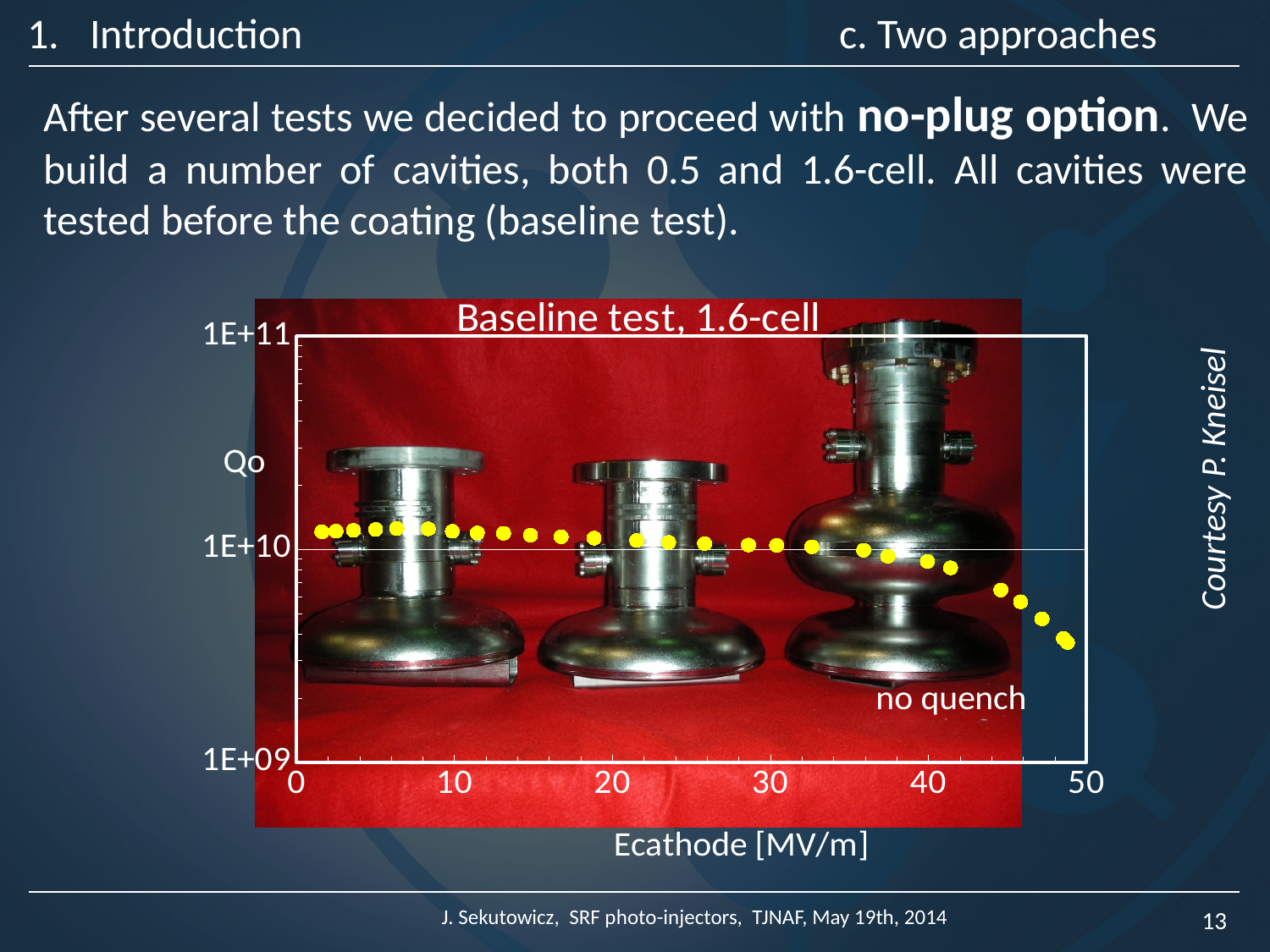
What kind of chart is shown on the slide? scatter chart Is the Qo value at an Ecathode of about 5 MV/m greater or less than 1E+10? greater Is the Qo value at the highest Ecathode point (near 48 MV/m) greater or less than 1E+10? less Which has the higher Qo: the point near 5 MV/m or the point near 48 MV/m? the point near 5 MV/m Is the Qo value at an Ecathode of about 10 MV/m greater or less than 1E+11? less What is the lowest tick value shown on the Qo axis? 1E+09 Does Qo rise or fall as Ecathode increases toward 50 MV/m? fall How many data series are plotted in the chart? 1 What is the maximum value shown on the x axis of the chart? 50 What is the label of the x axis of the chart? Ecathode [MV/m]